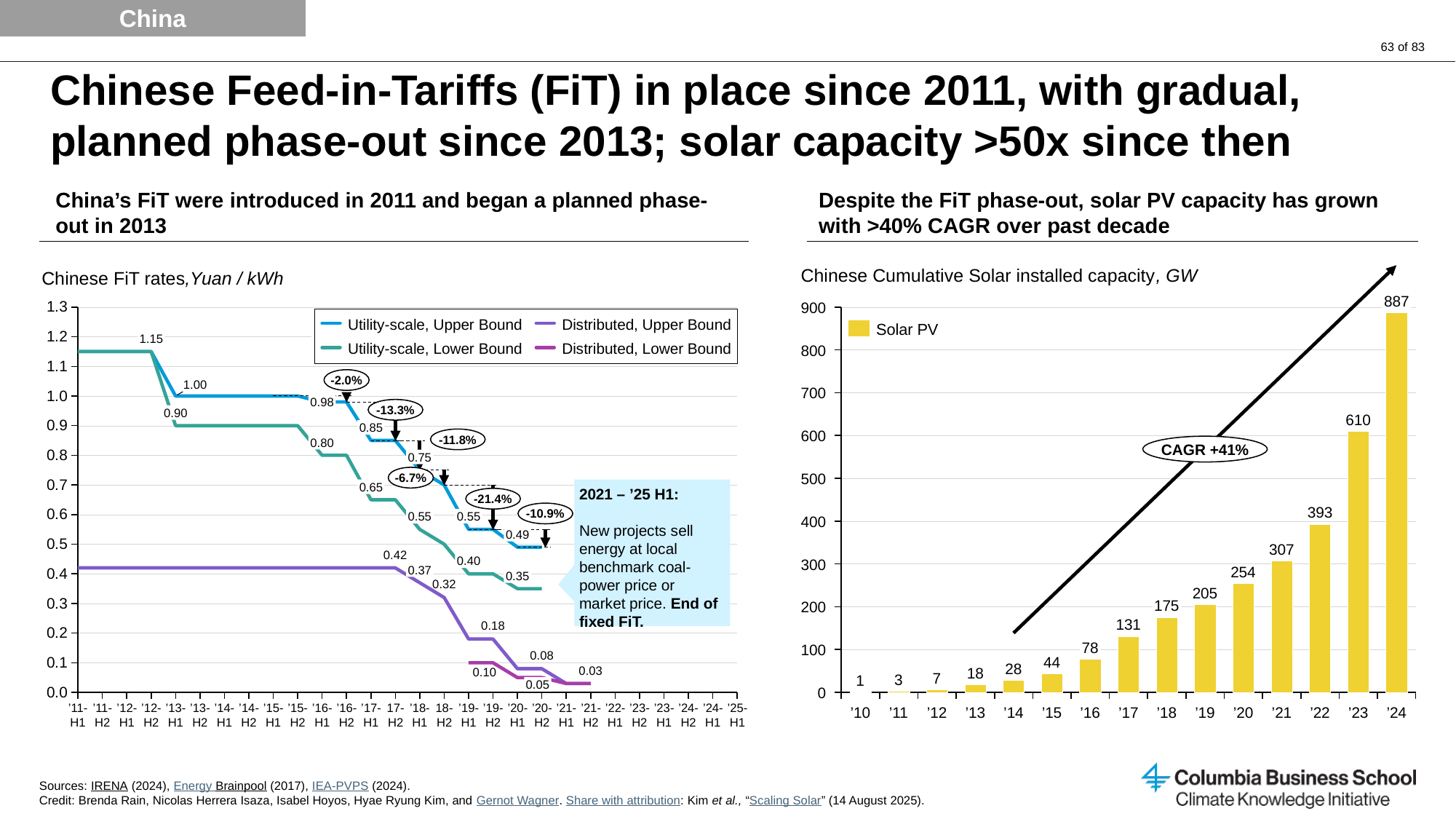
On the right chart (Chinese Cumulative Solar installed capacity), what is the difference between the values for '24 and '23? 277 On the right chart (Chinese Cumulative Solar installed capacity), what kind of chart is it? Bar chart On the left chart (Chinese FiT rates), what is the value of the Utility-scale, Upper Bound series in '11-H1? 1.15 On the left chart (Chinese FiT rates), what CAGR is annotated on the right chart's arrow? CAGR +41% On the right chart (Chinese Cumulative Solar installed capacity), do the values rise or fall from '10 to '24? Rise On the right chart (Chinese Cumulative Solar installed capacity), which year has the lowest value? '10 On the right chart (Chinese Cumulative Solar installed capacity), what is the value for '17? 131 On the right chart (Chinese Cumulative Solar installed capacity), what is the value for '24? 887 On the right chart (Chinese Cumulative Solar installed capacity), which is larger, the value for '19 or the value for '20? '20 On the right chart (Chinese Cumulative Solar installed capacity), which year has the highest value? '24 On the left chart (Chinese FiT rates), how many series does the legend list? 4 On the right chart (Chinese Cumulative Solar installed capacity), how many years are plotted? 15